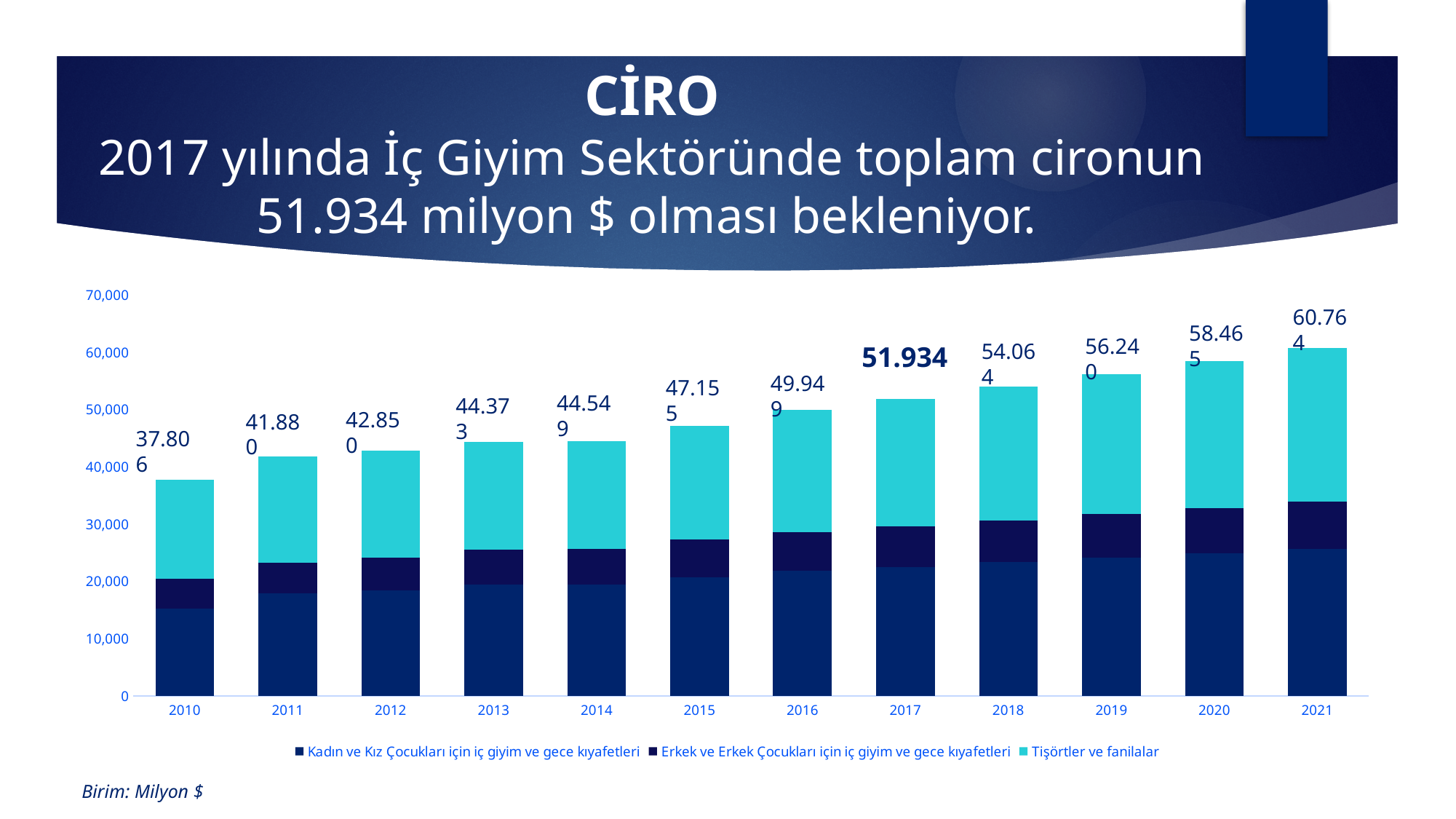
Which year has the lowest total turnover? 2010 What kind of chart is shown on the slide? stacked bar chart How many series does the legend list? 3 What is the difference between the total for 2021 and the total for 2010? 22.958 What is the total value labelled on the bar for 2010? 37.806 Is the 'Kadın ve Kız Çocukları için iç giyim ve gece kıyafetleri' segment for 2010 greater or less than 20,000? less What is the total value labelled on the bar for 2021? 60.764 What is the total turnover value labelled for 2017? 51.934 Which year has the highest total turnover? 2021 Do the total turnover values rise or fall from 2010 to 2021? rise Which year has the larger total, 2015 or 2016? 2016 How many years are shown on the x axis? 12